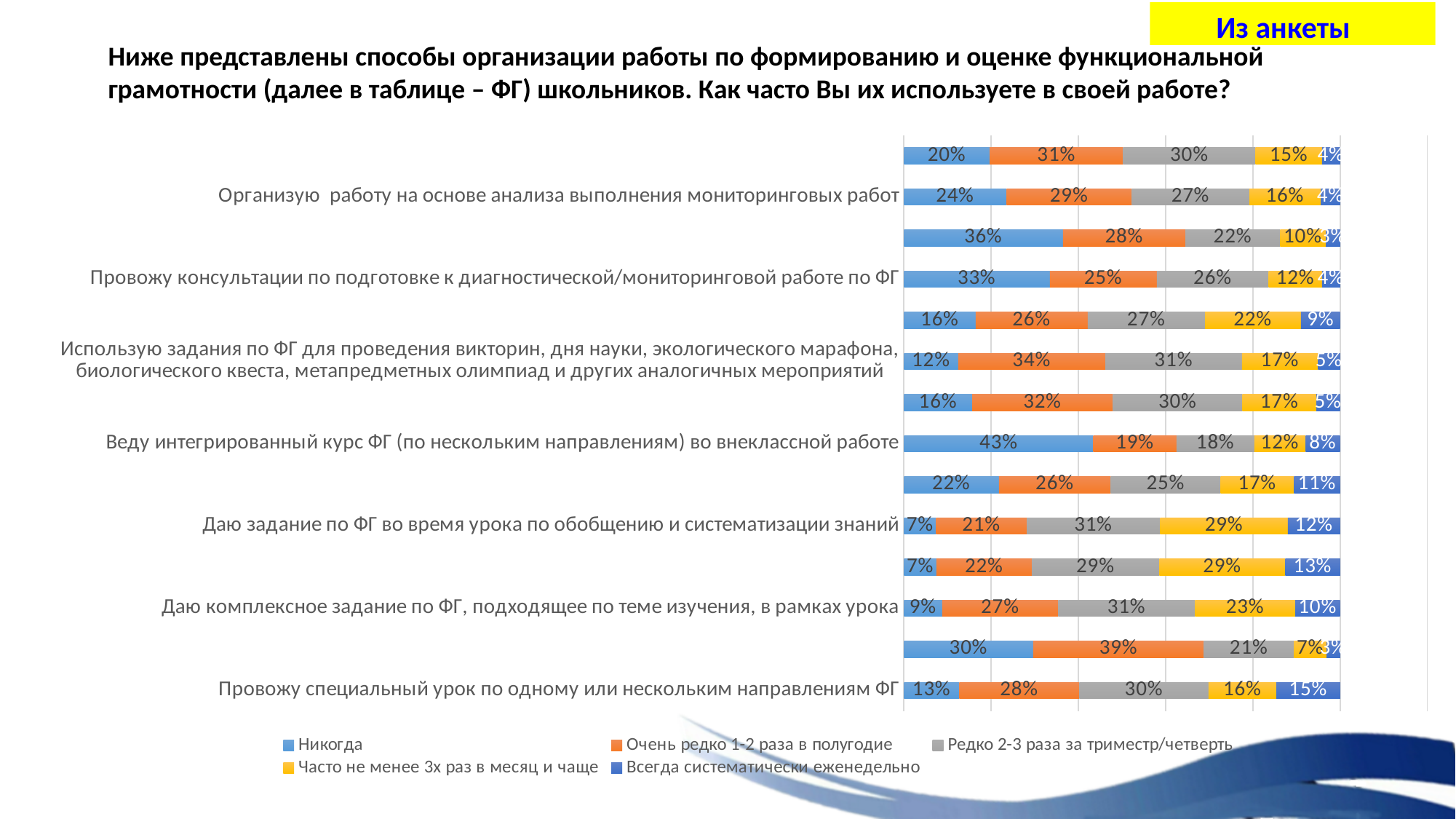
What is the value of "Очень редко 1-2 раза в полугодие" for "Использую задания по ФГ для проведения викторин, дня науки, экологического марафона, биологического квеста, метапредметных олимпиад и других аналогичных мероприятий"? 34% Which is larger: the "Всегда систематически еженедельно" value for "Даю комплексное задание по ФГ, подходящее по теме изучения, в рамках урока" or for "Провожу специальный урок по одному или нескольким направлениям ФГ"? Провожу специальный урок по одному или нескольким направлениям ФГ What is the value of "Всегда систематически еженедельно" for "Провожу специальный урок по одному или нескольким направлениям ФГ"? 15% What kind of chart is shown on the slide? stacked bar chart Which colour represents the series "Часто не менее 3х раз в месяц и чаще" in the legend? yellow How many series does the legend list? 5 What is the value of "Часто не менее 3х раз в месяц и чаще" for "Даю задание по ФГ во время урока по обобщению и систематизации знаний"? 29% Among the labelled categories, which has the highest "Никогда" value? Веду интегрированный курс ФГ (по нескольким направлениям) во внеклассной работе What is the difference between the "Никогда" values for "Провожу консультации по подготовке к диагностической/мониторинговой работе по ФГ" and "Организую работу на основе анализа выполнения мониторинговых работ"? 9% What is the value of "Никогда" for "Веду интегрированный курс ФГ (по нескольким направлениям) во внеклассной работе"? 43% Among the labelled categories, which has the lowest "Никогда" value? Даю задание по ФГ во время урока по обобщению и систематизации знаний What is the value of "Редко 2-3 раза за триместр/четверть" for "Провожу консультации по подготовке к диагностической/мониторинговой работе по ФГ"? 26%